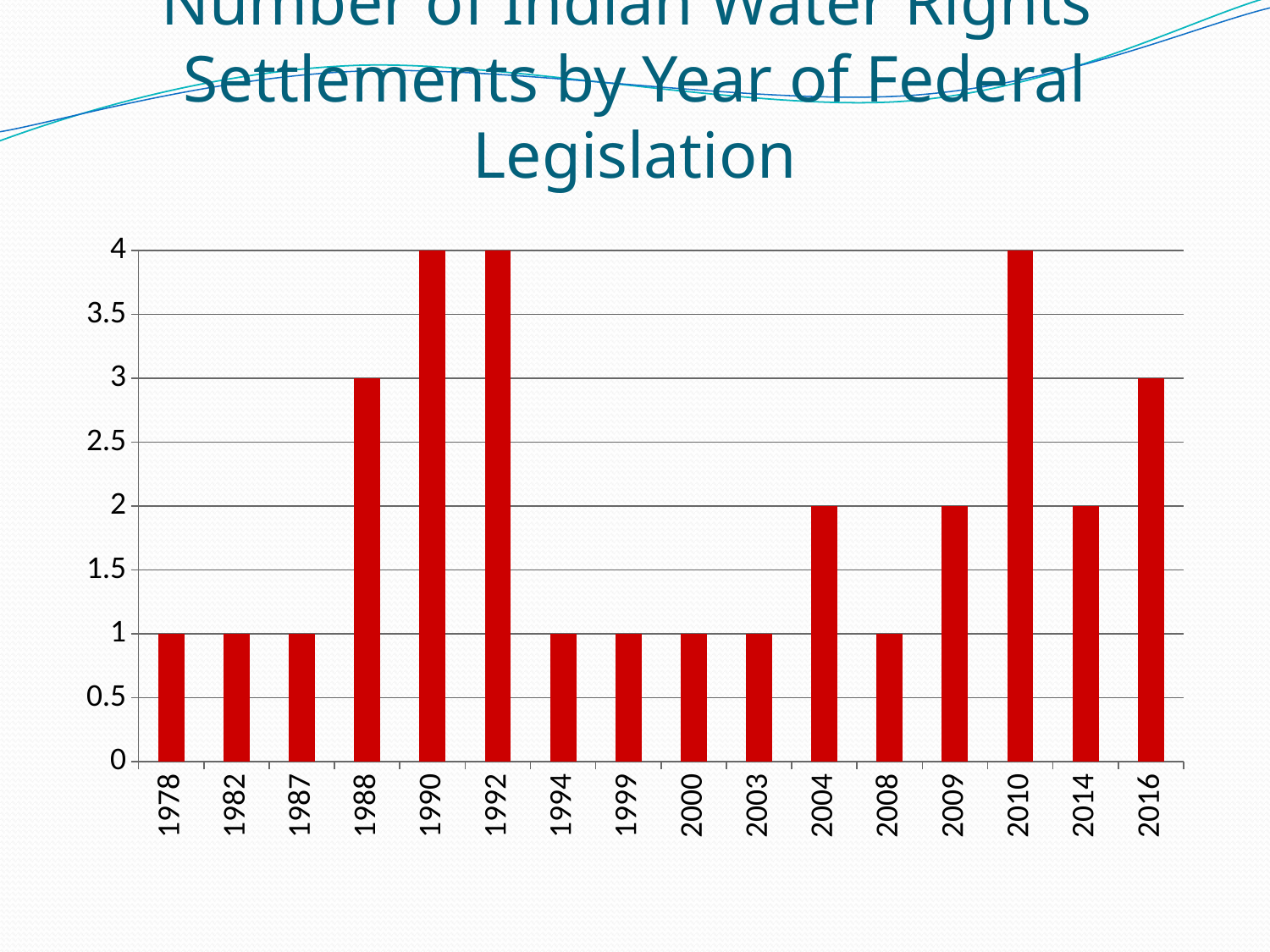
What is the value for 2016? 3 Which has the larger value, 1988 or 2004? 1988 What is the value for 1988? 3 What is the value for 1990? 4 What is the value for 2004? 2 What is the value for 1978? 1 Is the value for 2014 greater or less than 3? less What is the difference between the values for 1990 and 1988? 1 What kind of chart is shown on the slide? bar chart What is the difference between the values for 2010 and 2009? 2 What is the highest value reached by any bar in the chart? 4 How many years are shown on the x axis of the chart? 16